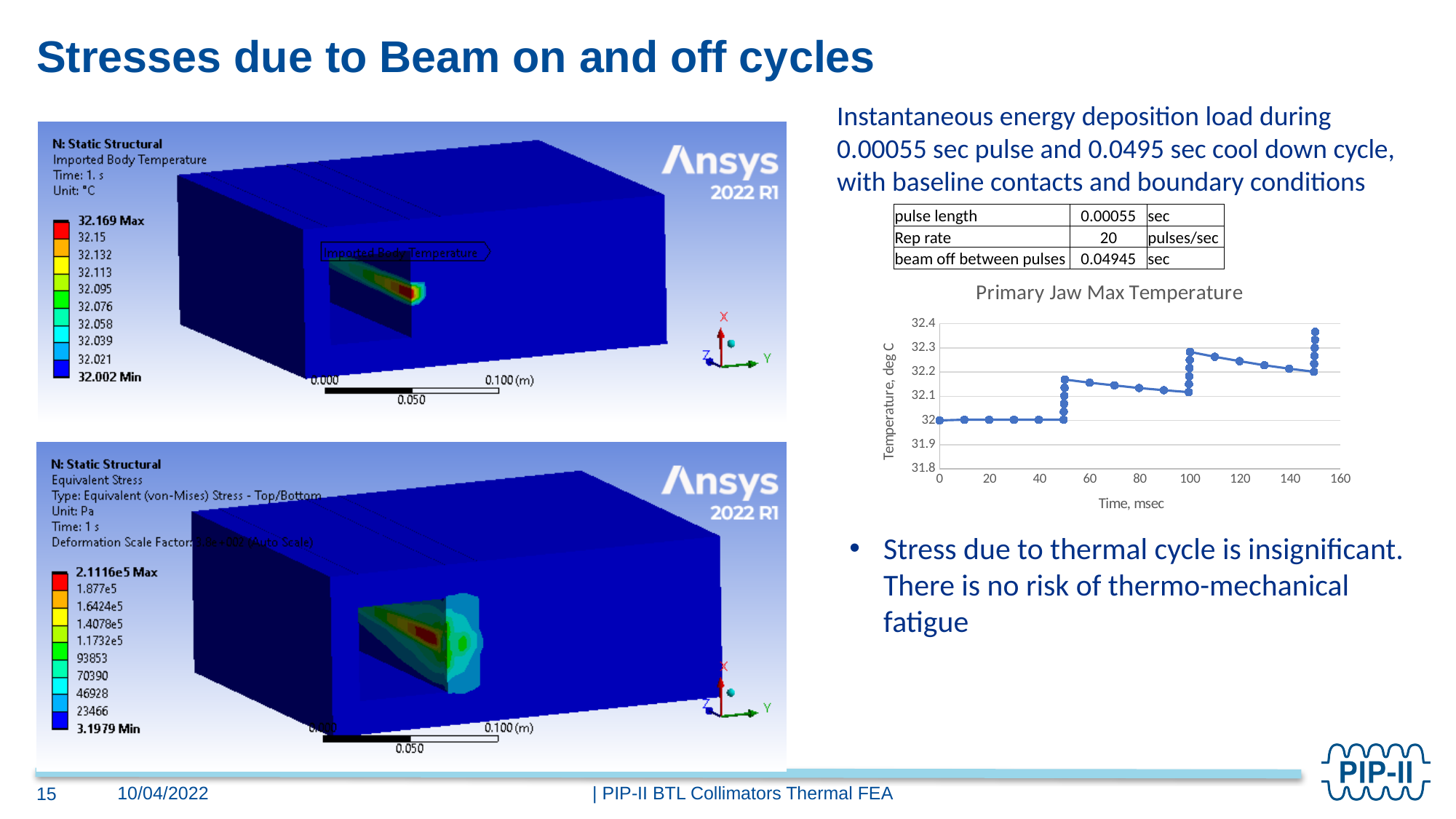
Which is larger in the Primary Jaw Max Temperature chart: the temperature at 30 msec or at 80 msec? 80 msec Is the temperature at 70 msec greater or less than 32.2 in the Primary Jaw Max Temperature chart? less What is the temperature at time 0 msec in the Primary Jaw Max Temperature chart? 32 Is the temperature at 70 msec greater or less than 32.1 in the Primary Jaw Max Temperature chart? greater Which is larger in the Primary Jaw Max Temperature chart: the temperature at 70 msec or at 120 msec? 120 msec Is the temperature at 120 msec greater or less than 32.2 in the Primary Jaw Max Temperature chart? greater Does the temperature in the Primary Jaw Max Temperature chart generally rise or fall as time increases? rise What is the label of the x axis of the Primary Jaw Max Temperature chart? Time, msec What is the highest value shown on the x axis of the Primary Jaw Max Temperature chart? 160 What is the title of the chart on the slide? Primary Jaw Max Temperature